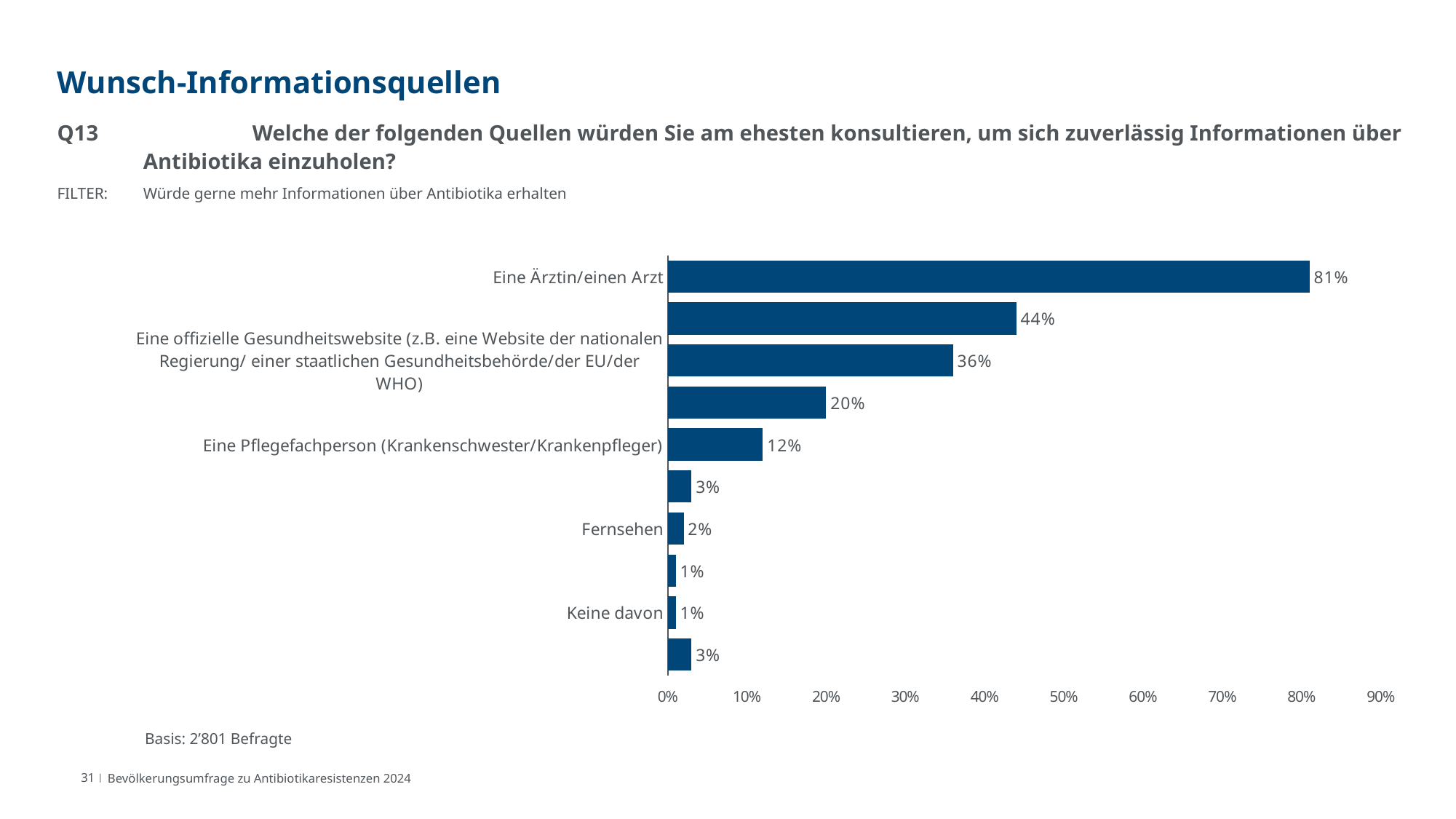
What is the title of the slide? Wunsch-Informationsquellen What kind of chart is shown on the slide? bar chart What is the value for "Keine davon"? 1% Which is larger, the value for "Fernsehen" or the value for "Eine Pflegefachperson (Krankenschwester/Krankenpfleger)"? Eine Pflegefachperson (Krankenschwester/Krankenpfleger) What is the value for "Eine Pflegefachperson (Krankenschwester/Krankenpfleger)"? 12% What is the value for "Eine Ärztin/einen Arzt"? 81% Is the value for "Eine Ärztin/einen Arzt" greater or less than 50%? greater How many bars are plotted in the chart? 10 What is the value for "Fernsehen"? 2% What is the value for "Eine offizielle Gesundheitswebsite (z.B. eine Website der nationalen Regierung/ einer staatlichen Gesundheitsbehörde/der EU/der WHO)"? 36% Which category has the highest value? Eine Ärztin/einen Arzt What is the difference between the values for "Eine Ärztin/einen Arzt" and "Eine Pflegefachperson (Krankenschwester/Krankenpfleger)"? 69 percentage points